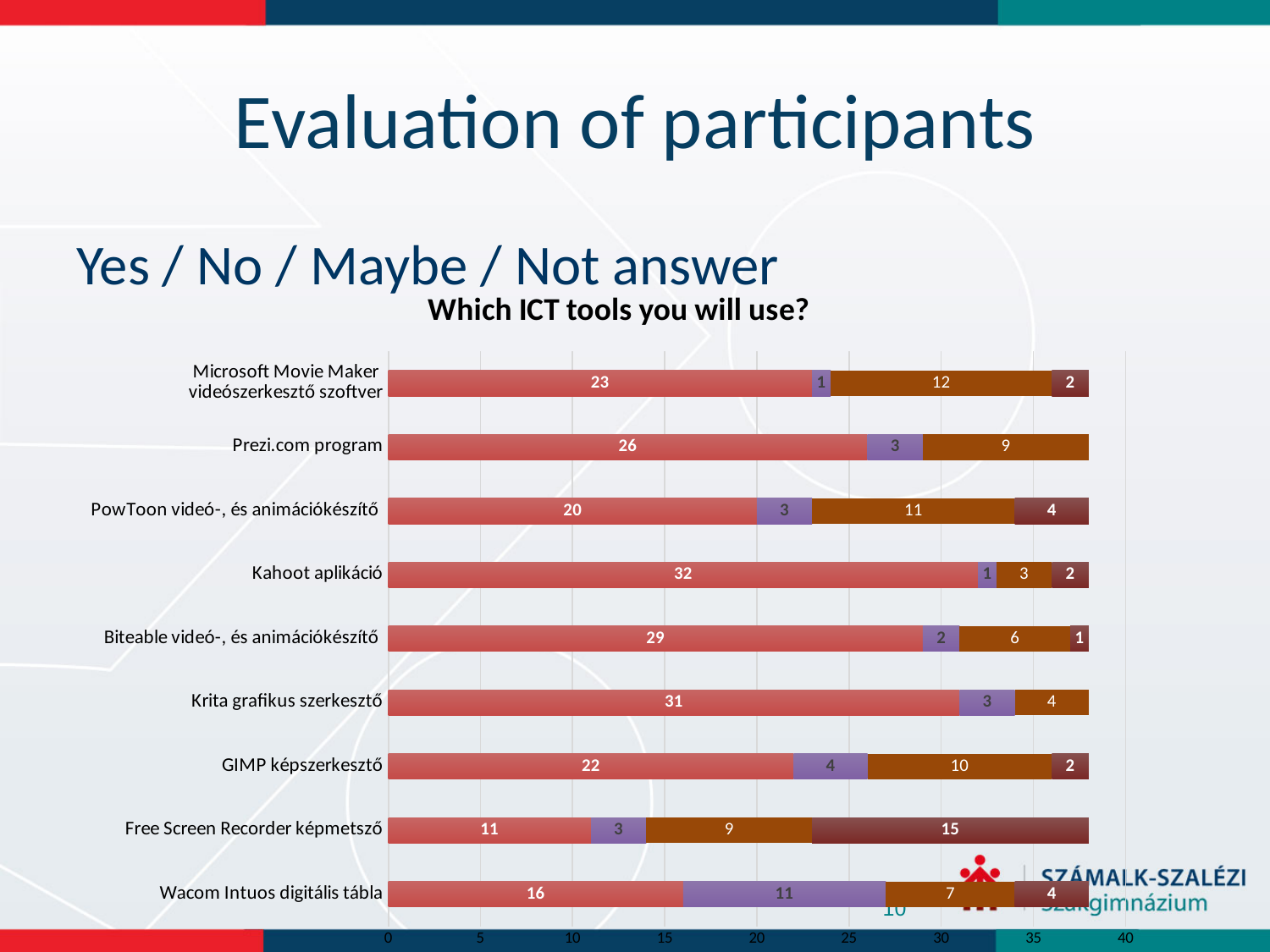
What is the total of all segments in the bar for Wacom Intuos digitális tábla? 38 What kind of chart is shown on the slide? stacked bar chart What is the value of the second (purple) segment for Wacom Intuos digitális tábla? 11 Which ICT tool has the largest first (red) segment? Kahoot aplikáció What is the value of the first (red) segment for Prezi.com program? 26 What is the title of the chart? Which ICT tools you will use? What is the difference between the first (red) segment values of Krita grafikus szerkesztő and GIMP képszerkesztő? 9 Which ICT tool has the smallest first (red) segment? Free Screen Recorder képmetsző What is the value of the first (red) segment for Kahoot aplikáció? 32 What is the value of the last (dark red) segment for Free Screen Recorder képmetsző? 15 Which has a larger first (red) segment value: Microsoft Movie Maker videószerkesztő szoftver or PowToon videó-, és animációkészítő? Microsoft Movie Maker videószerkesztő szoftver How many ICT tools (categories) are listed on the chart? 9